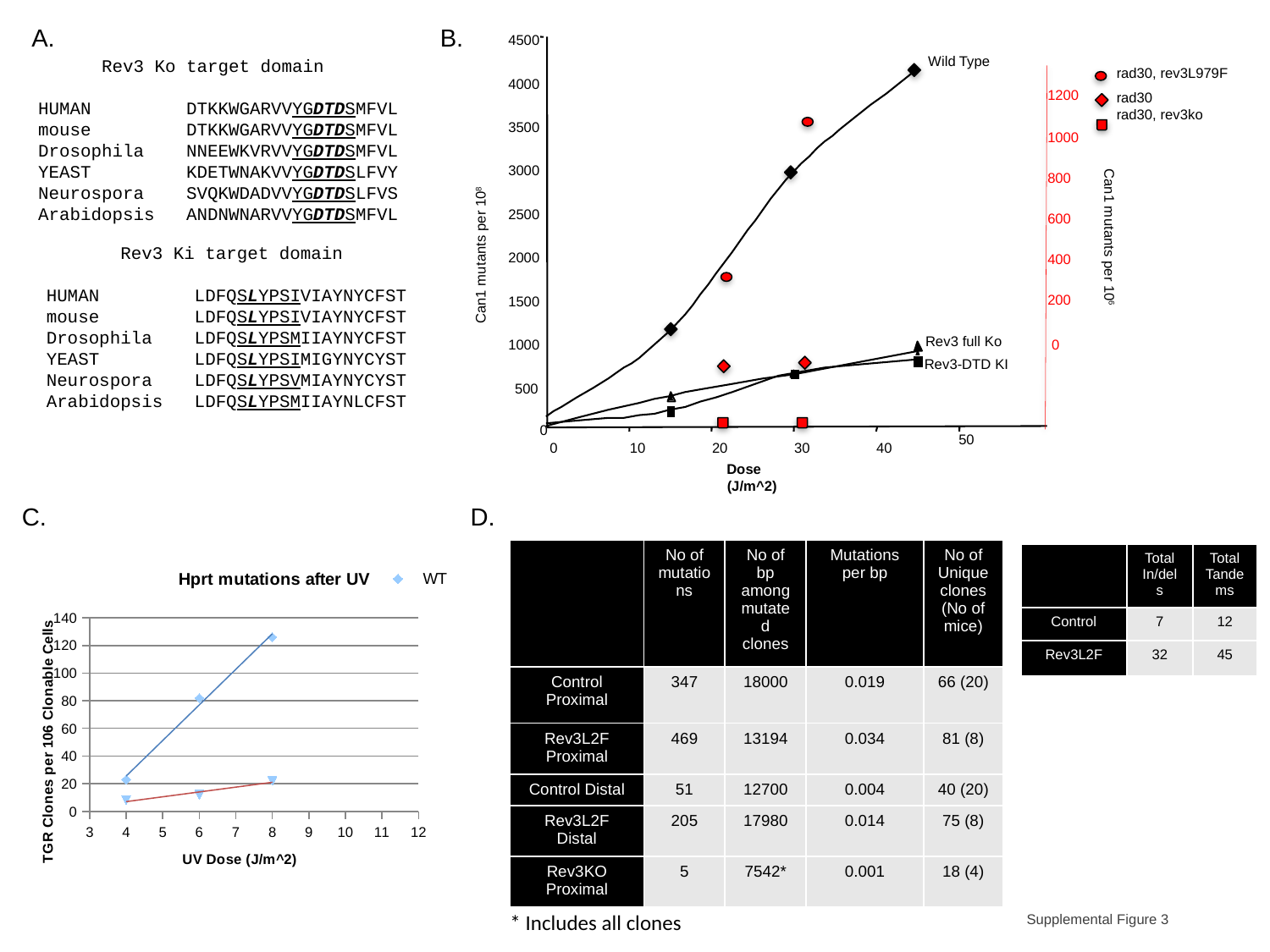
In the chart in panel B, does the Wild Type series rise or fall as dose increases? rise In the chart in panel C, how many series does the legend list? 1 In the chart in panel B, at a dose of about 30 J/m^2, which is larger: the Wild Type value or the Rev3 full Ko value? Wild Type In the chart in panel B, what is the label of the x axis? Dose (J/m^2) What is the title of the chart in panel C? Hprt mutations after UV In the chart in panel C, do the WT values rise or fall as UV dose increases? rise In the chart in panel B, is the Rev3-DTD KI value at the highest dose (around 45 J/m^2) greater or less than 1000 on the left axis? less In the chart in panel B, how many series does the red legend on the right list? 3 In the chart in panel C, is the WT value at a UV dose of 8 J/m^2 greater or less than 100? greater In the chart in panel B, is the Wild Type value at the highest dose (around 45 J/m^2) greater or less than 4000 on the left axis? greater In the chart in panel B, which black series reaches the highest Can1 mutants per 10^8 value? Wild Type